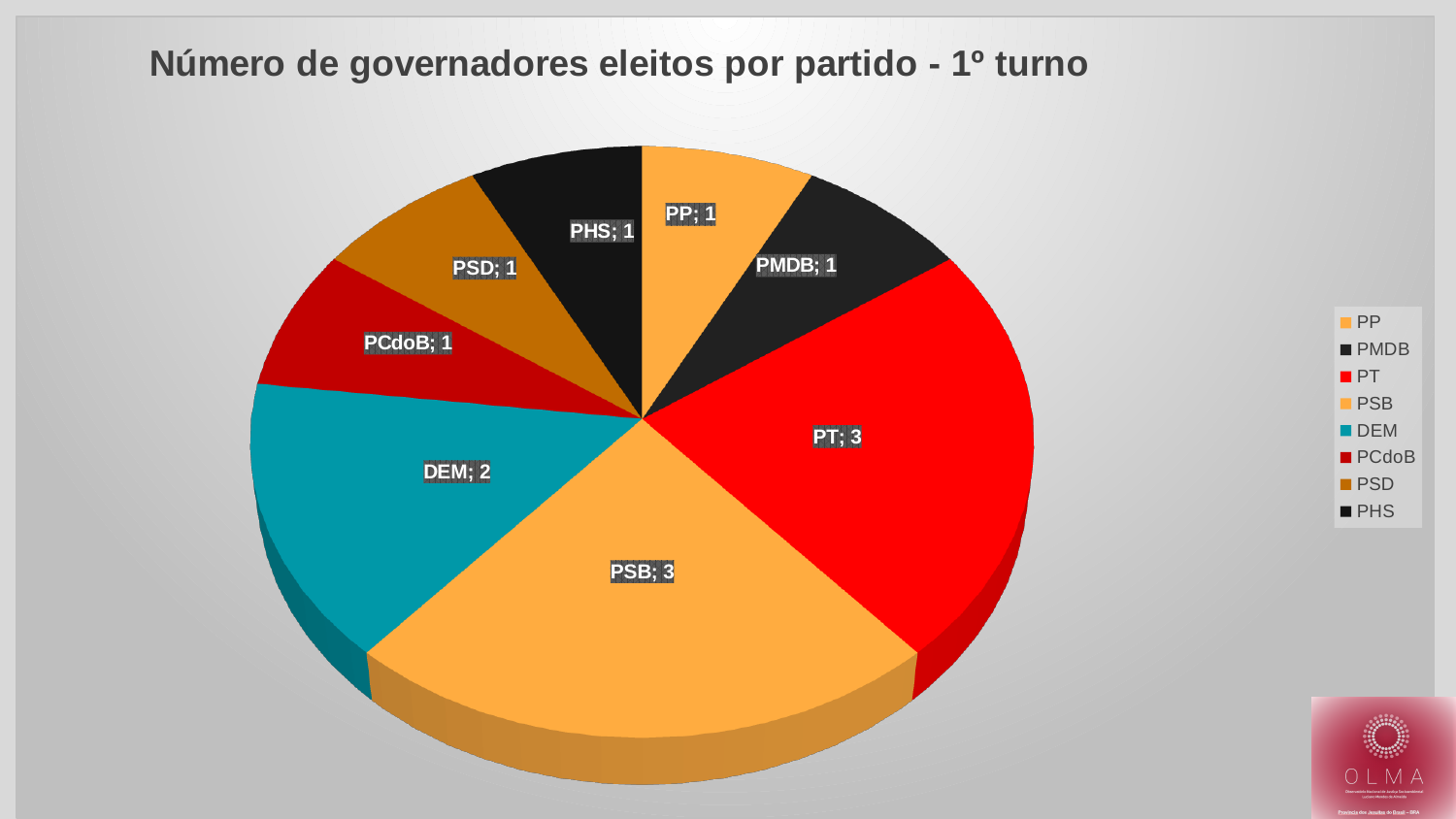
What value is shown for the PSB slice? 3 What value is shown for the PCdoB slice? 1 What value is shown for the DEM slice? 2 What is the difference between the values for PT and DEM? 1 How many parties (slices) are shown in the pie chart? 8 How many governors were elected for PT according to the chart? 3 How many entries does the legend list? 8 What is the title of the chart? Número de governadores eleitos por partido - 1º turno What kind of chart is shown on the slide? pie chart What is the total of all the slice values in the pie chart? 13 Which is larger, the value for PT or the value for DEM? PT Which is larger, the value for PSB or the value for PP? PSB